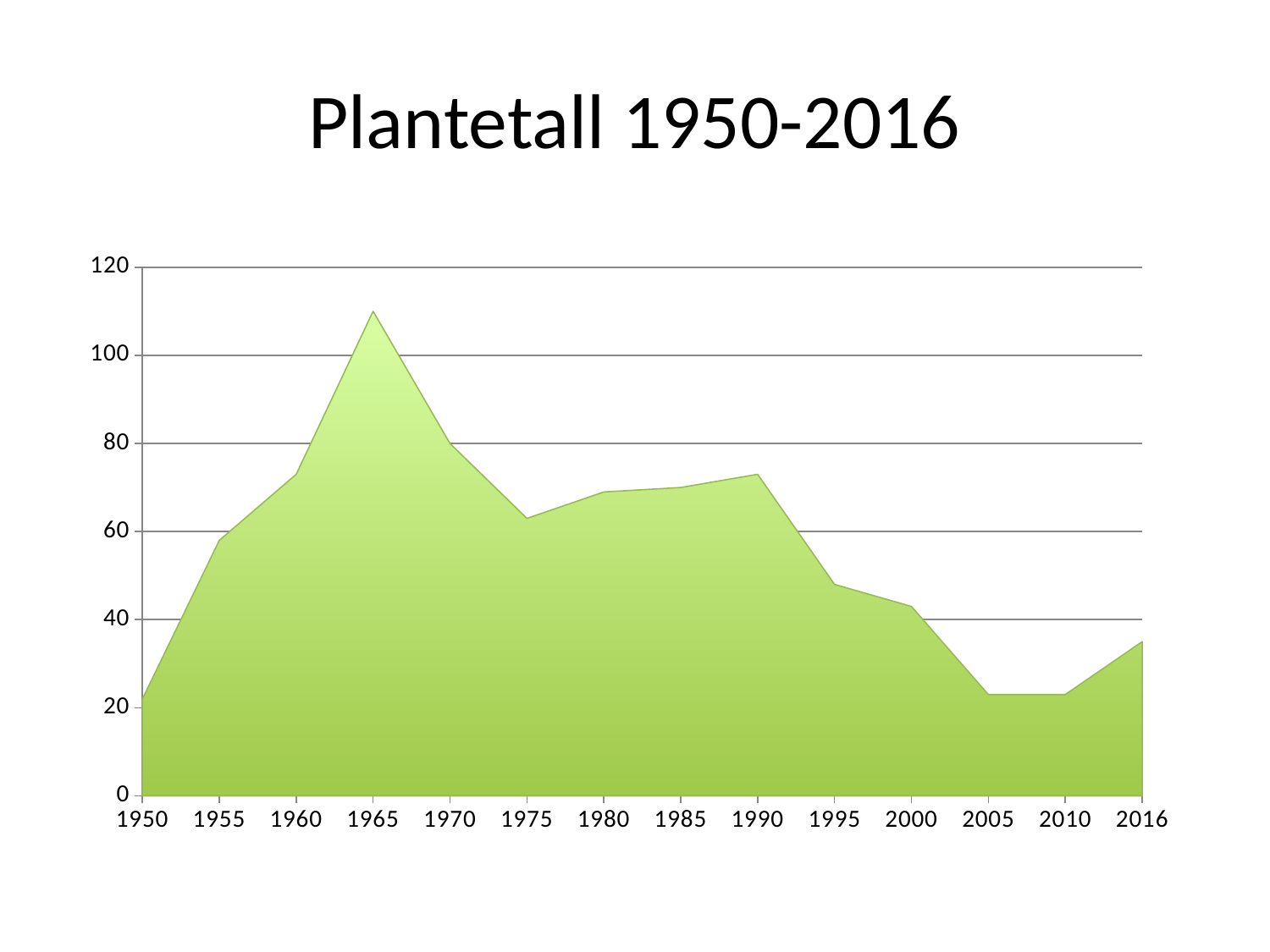
Is the value for 1970 greater or less than 60? greater Which is larger, the value for 1965 or the value for 1990? 1965 Do the values rise or fall from 1990 to 2005? fall Is the value for 2005 greater or less than 40? less What is the title of the chart? Plantetall 1950-2016 What kind of chart is shown on the slide? area chart Is the value for 1950 greater or less than 40? less Which year has the highest value in the chart? 1965 How many years are marked along the x axis of the chart? 14 Which is larger, the value for 1955 or the value for 2000? 1955